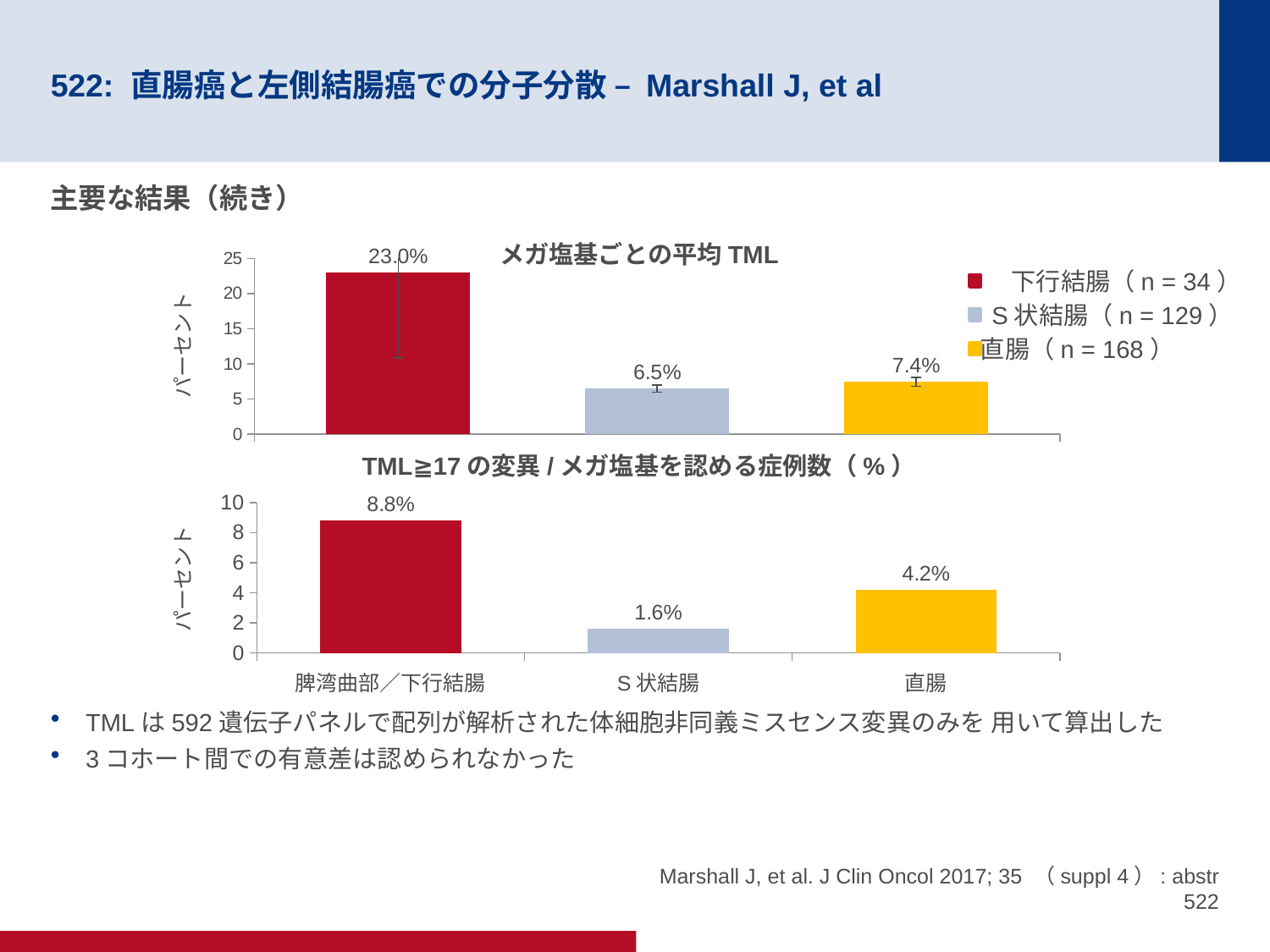
In the top chart (メガ塩基ごとの平均 TML), what is the value for S状結腸? 6.5% In the bottom chart (TML≧17 の変異 / メガ塩基を認める症例数), what is the value for S状結腸? 1.6% In the bottom chart (TML≧17 の変異 / メガ塩基を認める症例数), what is the value for 脾湾曲部／下行結腸? 8.8% What kind of chart is the bottom chart (TML≧17 の変異 / メガ塩基を認める症例数)? Bar chart In the top chart (メガ塩基ごとの平均 TML), what is the value for 直腸? 7.4% In the top chart (メガ塩基ごとの平均 TML), what is the difference between the values for 直腸 and S状結腸? 0.9% In the bottom chart (TML≧17 の変異 / メガ塩基を認める症例数), which group has the lowest value? S状結腸 In the top chart (メガ塩基ごとの平均 TML), which group has the highest value? 下行結腸 In the bottom chart (TML≧17 の変異 / メガ塩基を認める症例数), what is the value for 直腸? 4.2% How many groups does the legend of the top chart list? 3 In the bottom chart (TML≧17 の変異 / メガ塩基を認める症例数), which is larger, the value for 直腸 or for S状結腸? 直腸 In the top chart (メガ塩基ごとの平均 TML), what is the value for 下行結腸? 23.0%